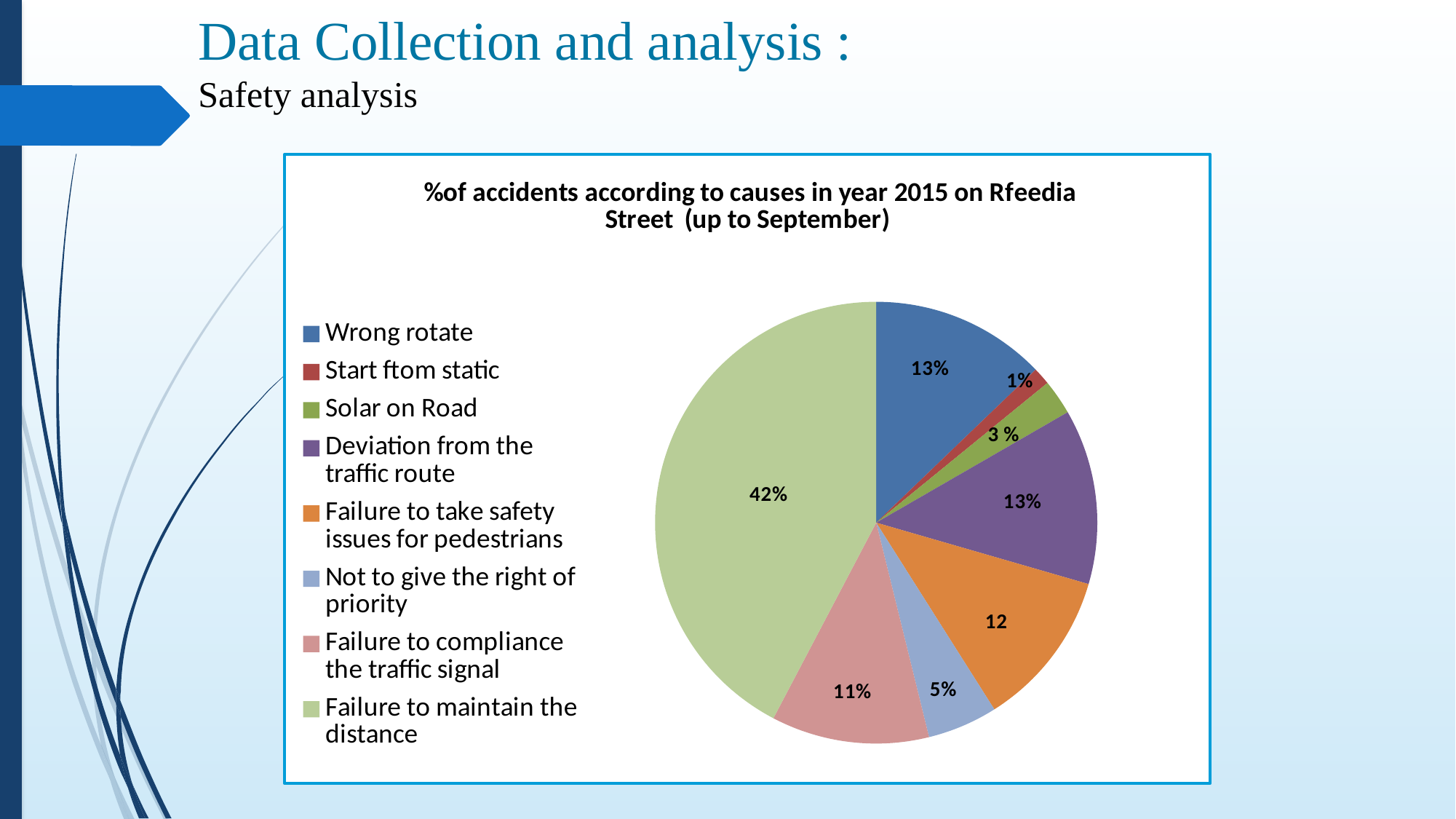
What share of accidents is attributed to Wrong rotate? 13% What value is shown for Failure to compliance the traffic signal? 11% What value is shown for Start ftom static? 1% What value is shown for Not to give the right of priority? 5% What is the difference between the share for Failure to maintain the distance and the share for Wrong rotate? 29% Which is larger: the share for Failure to compliance the traffic signal or the share for Not to give the right of priority? Failure to compliance the traffic signal Which cause accounts for the largest share of accidents? Failure to maintain the distance How many categories does the pie chart show? 8 What is the title of the chart? %of accidents according to causes in year 2015 on Rfeedia Street (up to September) Which cause accounts for the smallest share of accidents? Start ftom static What type of chart is shown on the slide? pie chart What share of accidents is attributed to Failure to maintain the distance? 42%